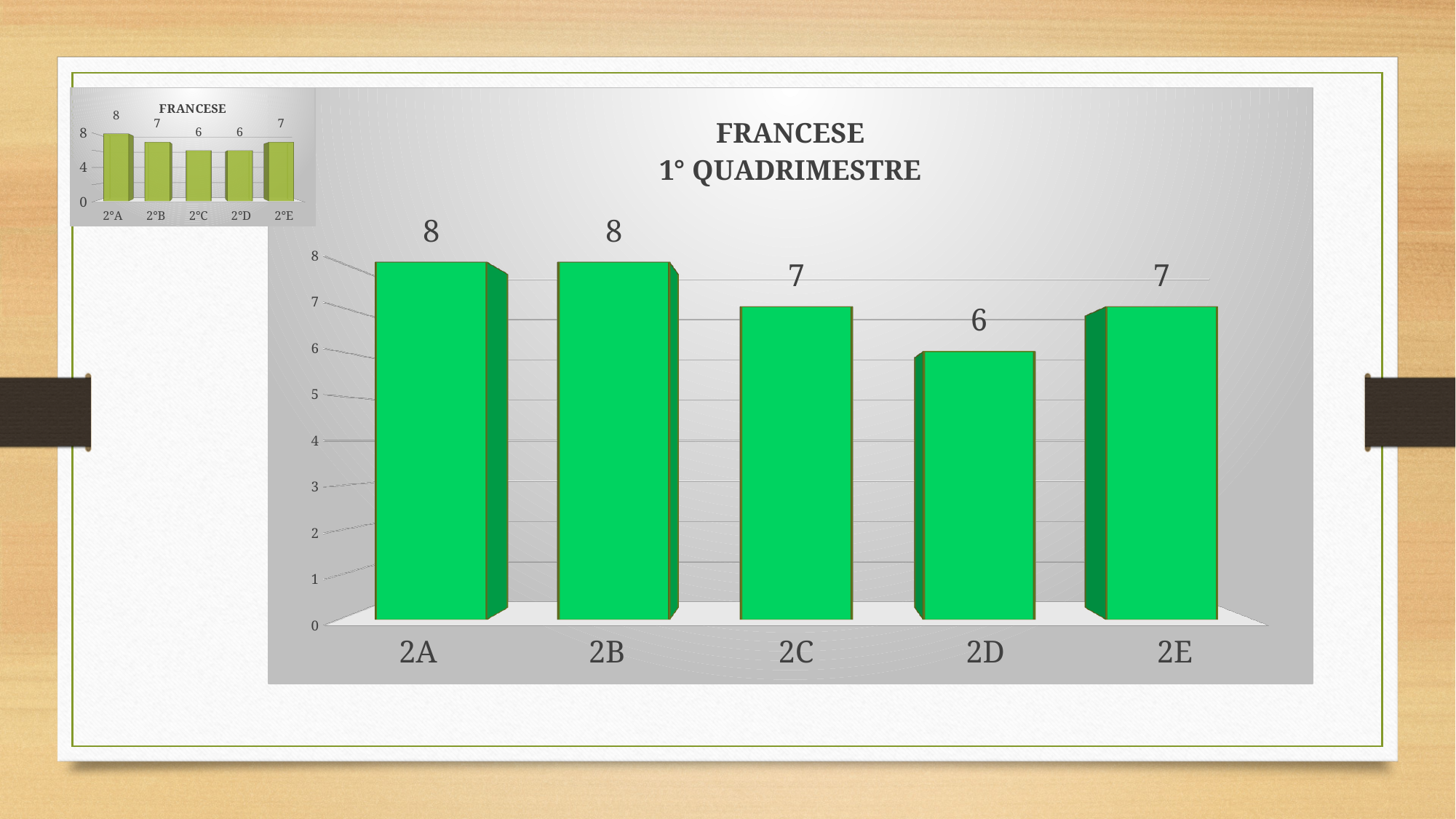
In the small chart at the top left titled "FRANCESE", what is the value for 2°A? 8 In the large chart titled "FRANCESE 1° QUADRIMESTRE", what is the value for 2D? 6 In the large chart titled "FRANCESE 1° QUADRIMESTRE", which is larger, the value for 2C or the value for 2D? 2C What kind of chart is the large chart titled "FRANCESE 1° QUADRIMESTRE"? bar chart In the small chart at the top left titled "FRANCESE", what is the value for 2°B? 7 What is the title of the large chart on the slide? FRANCESE 1° QUADRIMESTRE In the large chart titled "FRANCESE 1° QUADRIMESTRE", how many categories are shown on the x axis? 5 In the large chart titled "FRANCESE 1° QUADRIMESTRE", which category has the lowest value? 2D In the large chart titled "FRANCESE 1° QUADRIMESTRE", what is the difference between the values for 2A and 2D? 2 In the small chart at the top left titled "FRANCESE", what is the difference between the values for 2°A and 2°C? 2 In the small chart at the top left titled "FRANCESE", which category has the highest value? 2°A In the large chart titled "FRANCESE 1° QUADRIMESTRE", what is the value for 2C? 7